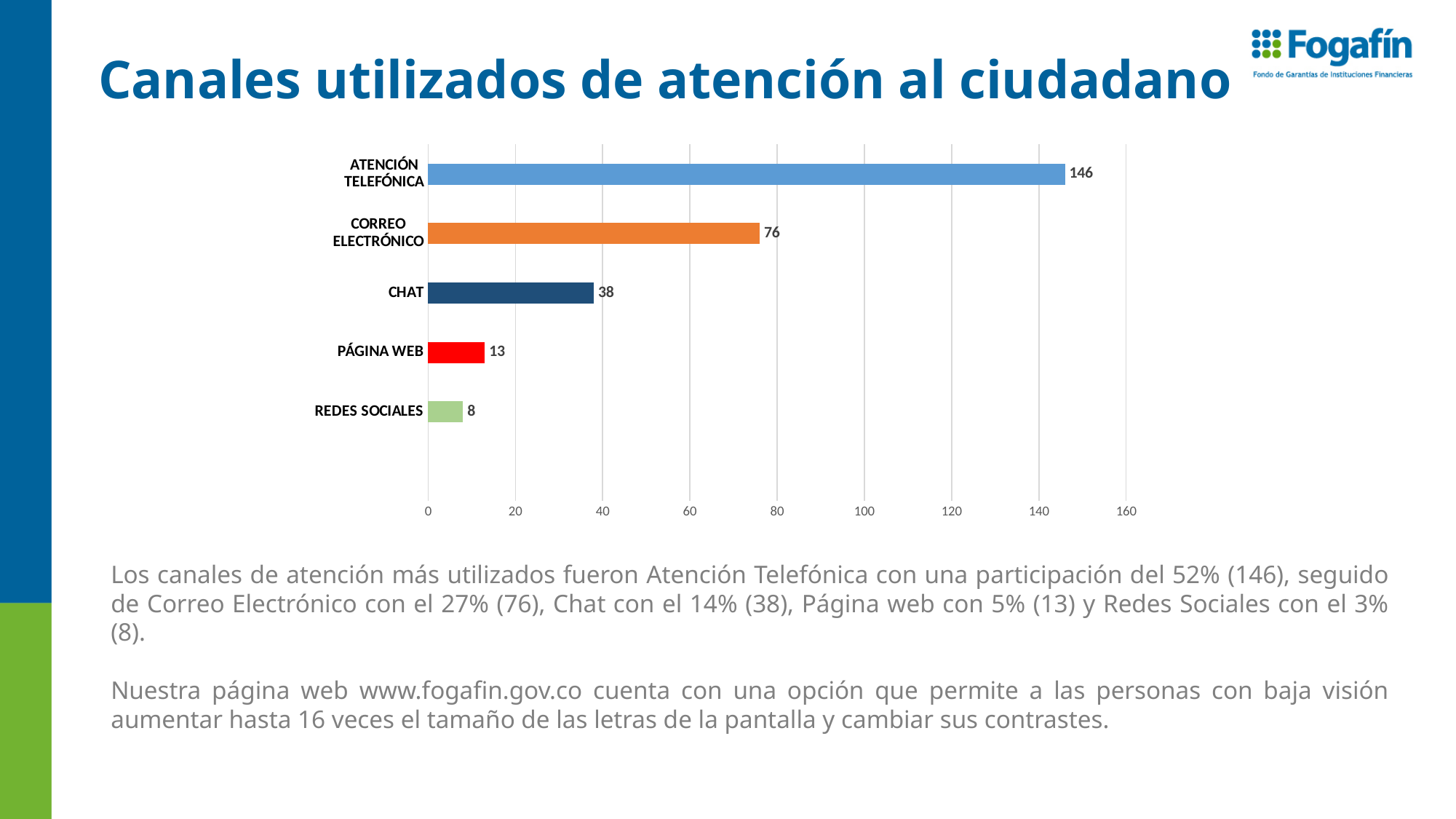
What is the value for CORREO ELECTRÓNICO? 76 What is the value for ATENCIÓN TELEFÓNICA? 146 Which channel has the lowest value? REDES SOCIALES What is the value for CHAT? 38 Which is larger, the value for CHAT or the value for PÁGINA WEB? CHAT Is the value for CORREO ELECTRÓNICO greater or less than 80? less How many channels are shown in the chart? 5 What is the title of the slide? Canales utilizados de atención al ciudadano What is the value for PÁGINA WEB? 13 What is the difference between the values for ATENCIÓN TELEFÓNICA and CORREO ELECTRÓNICO? 70 What kind of chart is shown on the slide? bar chart Which channel has the highest value? ATENCIÓN TELEFÓNICA